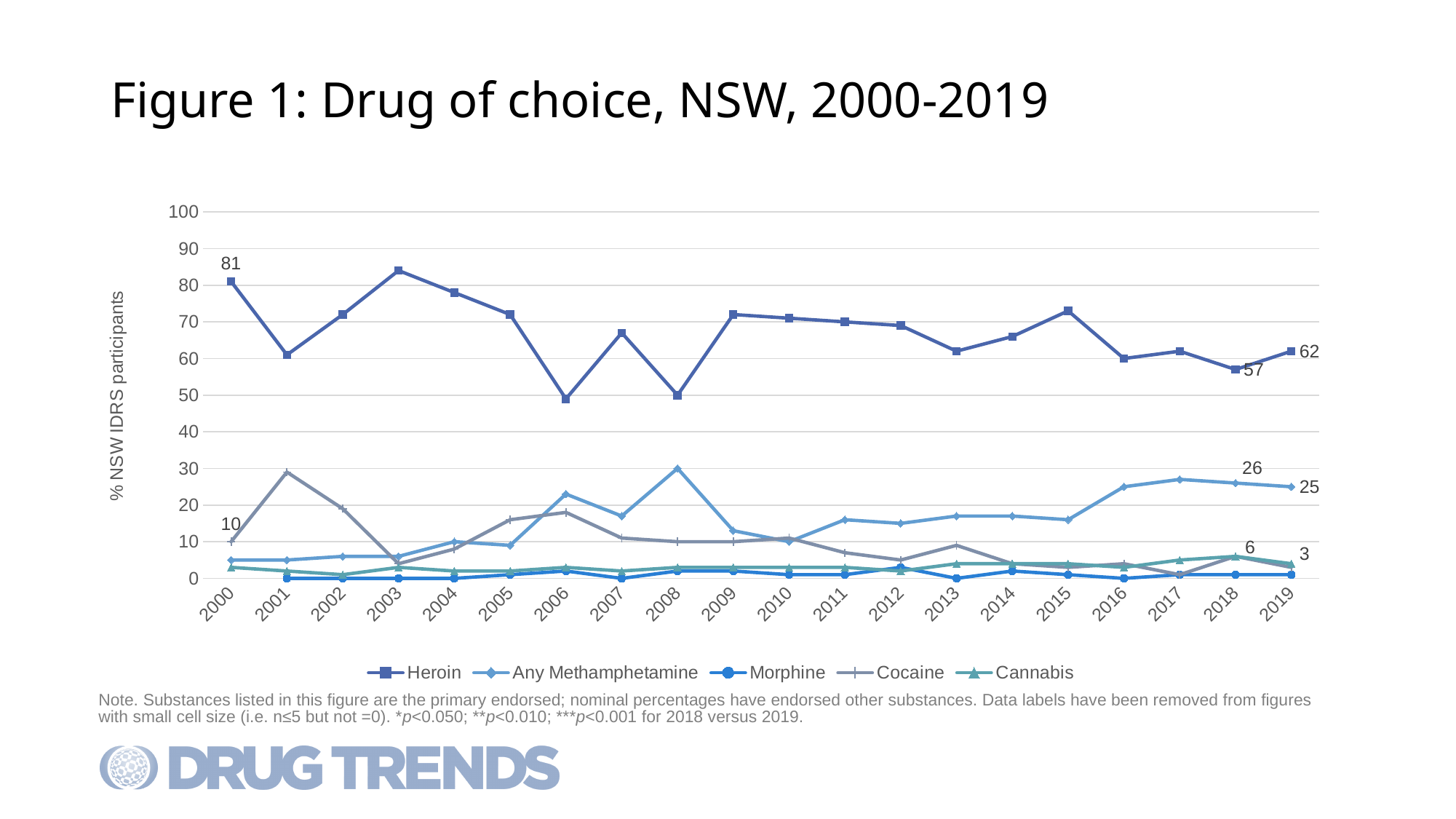
What is the value for Any Methamphetamine in 2019? 25 How many series does the legend list? 5 Is the value for Heroin in 2003 greater or less than 80? greater Is the value for Cocaine in 2001 greater or less than 20? greater What is the label on the vertical axis? % NSW IDRS participants What is the difference between the Heroin values in 2000 and 2019? 19 What is the value for Heroin in 2000? 81 What is the value for Heroin in 2019? 62 What is the value for Any Methamphetamine in 2018? 26 Which series has the highest value in 2019? Heroin What is the difference between the Heroin values in 2018 and 2019? 5 What kind of chart is shown on the slide? Line chart